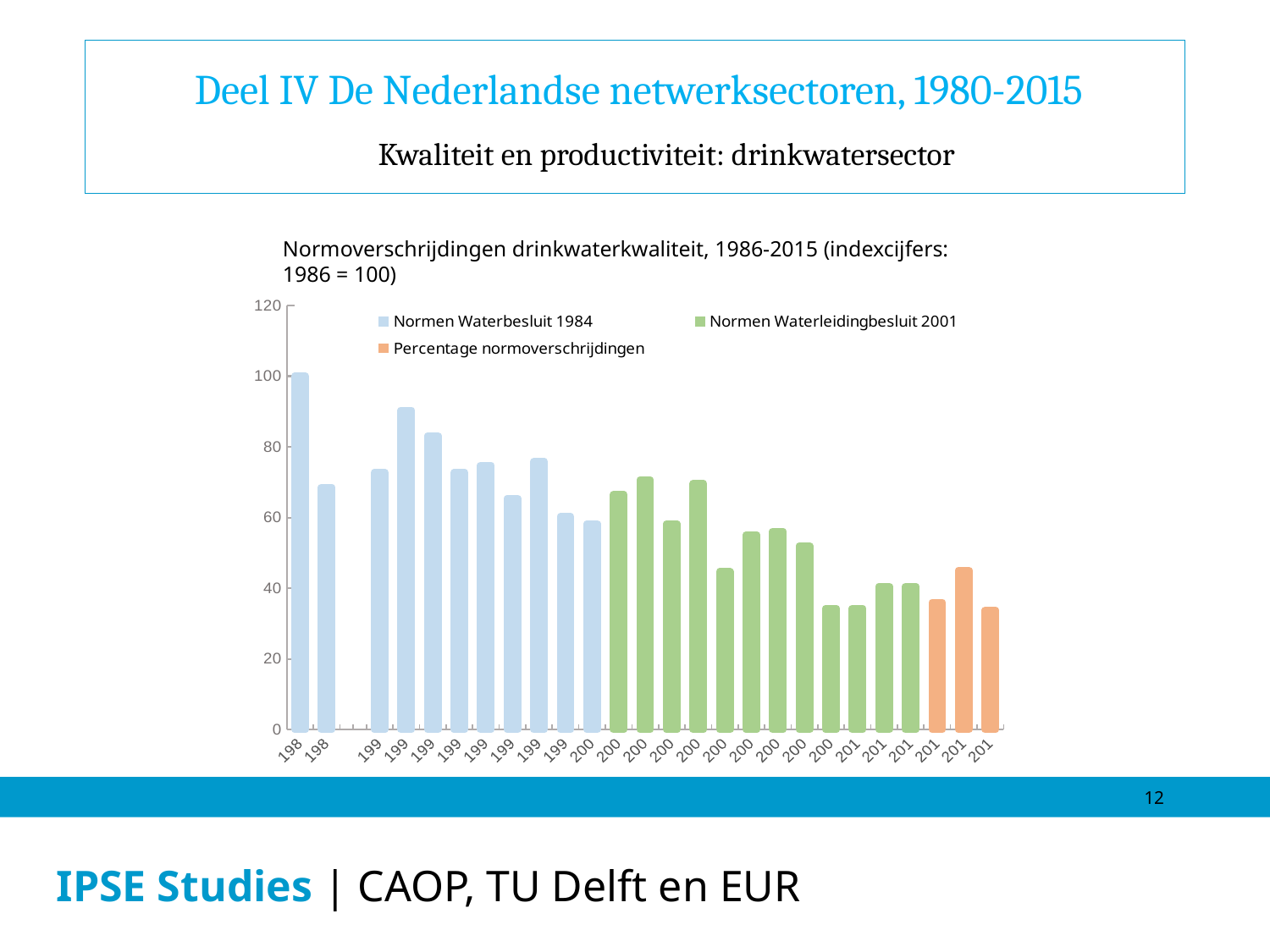
Do the values generally rise or fall from left to right along the x axis? fall Which series contains the highest bar in the chart? Normen Waterbesluit 1984 How many orange (Percentage normoverschrijdingen) bars are plotted? 3 Which bar in the chart is the highest? the leftmost bar Is the tallest orange (Percentage normoverschrijdingen) bar greater or less than 40? greater Is the tallest green (Normen Waterleidingbesluit 2001) bar greater or less than 60? greater Is the value of the rightmost bar greater or less than 40? less What kind of chart is shown on the slide? bar chart Which series is shown in orange? Percentage normoverschrijdingen How many series does the legend list? 3 What is the title of the chart? Normoverschrijdingen drinkwaterkwaliteit, 1986-2015 (indexcijfers: 1986 = 100)